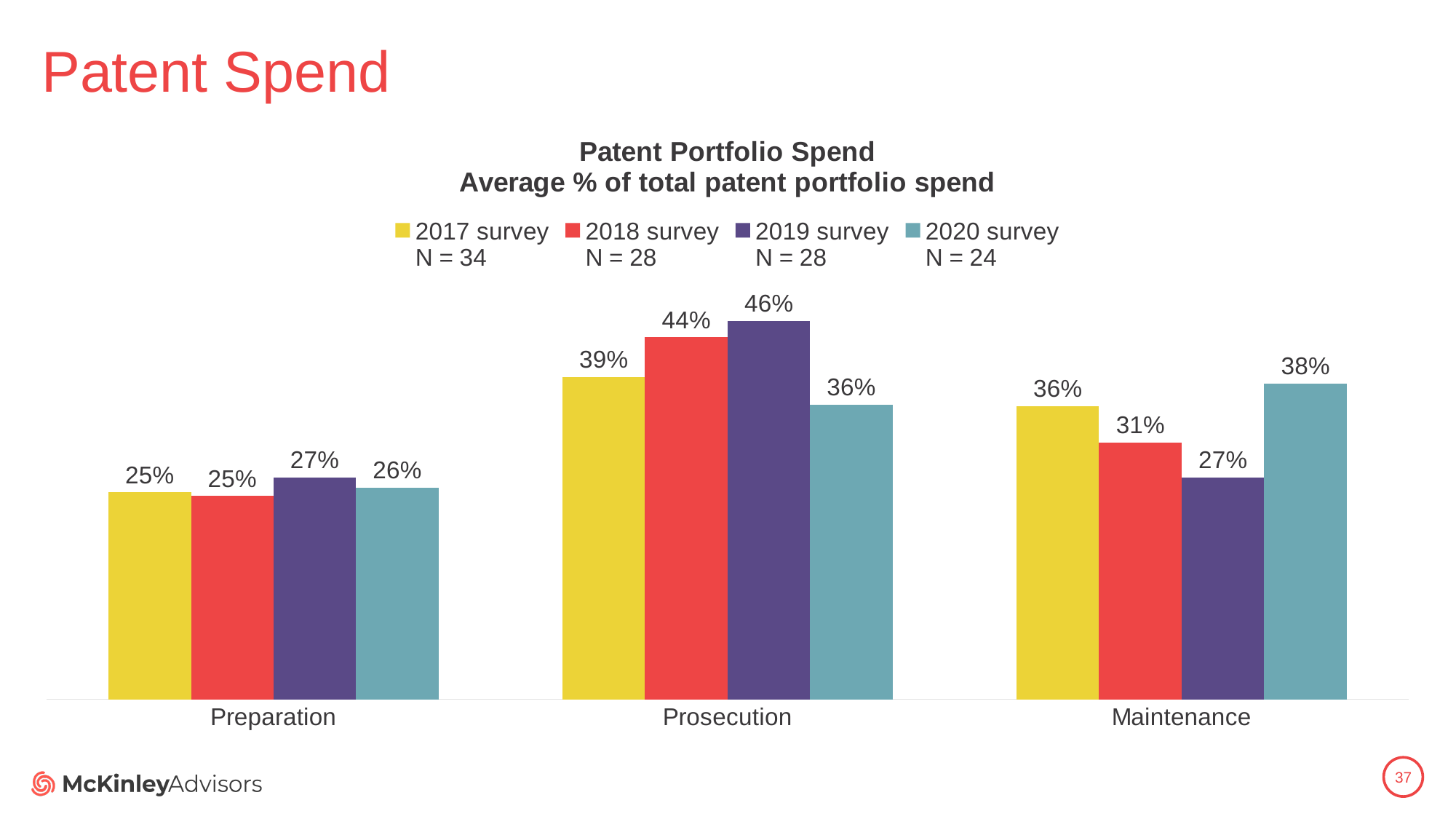
What is the sample size (N) for the 2017 survey shown in the legend? N = 34 How many categories are shown on the x axis? 3 What is the value for Prosecution in the 2019 survey? 46% What is the value for Maintenance in the 2020 survey? 38% Which category has the lowest value in the 2020 survey? Preparation What is the value for Preparation in the 2017 survey? 25% What is the difference between the 2017 survey and 2019 survey values for Maintenance? 9% How many series does the legend list? 4 Which category has the highest value in the 2018 survey? Prosecution What kind of chart is shown on the slide? Bar chart Which is larger for Maintenance: the 2018 survey value or the 2020 survey value? 2020 survey What is the difference between the 2019 survey and 2020 survey values for Prosecution? 10%